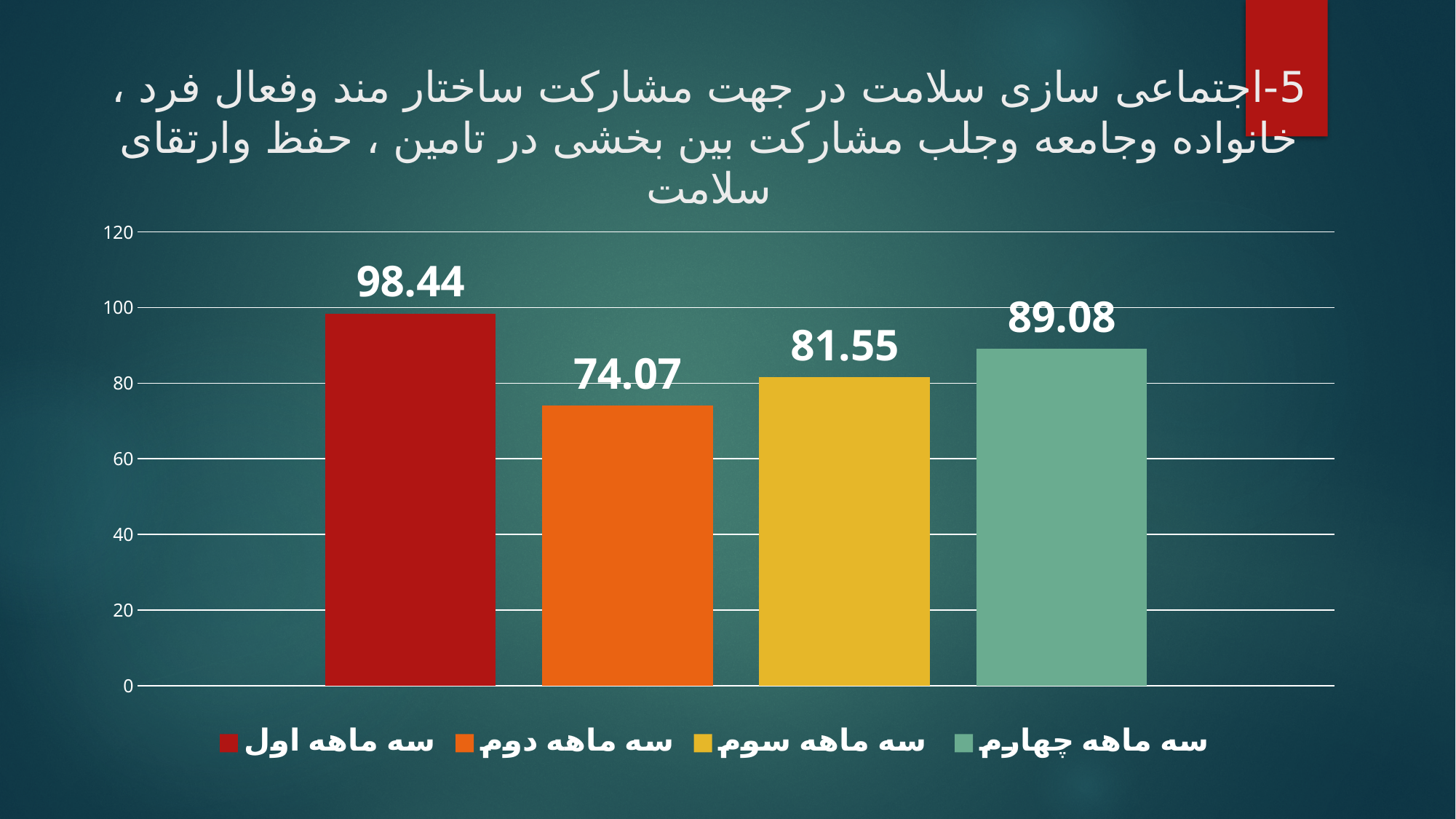
What is the value for سه ماهه سوم? 81.55 What kind of chart is shown on the slide? bar chart What is the value for سه ماهه اول? 98.44 Which quarter has the highest value? سه ماهه اول Is the value for سه ماهه اول greater or less than 100? less Which quarter has the lowest value? سه ماهه دوم How many entries does the legend list? 4 What is the value for سه ماهه دوم? 74.07 What is the difference between the values for سه ماهه اول and سه ماهه دوم? 24.37 Which is larger, the value for سه ماهه سوم or سه ماهه چهارم? سه ماهه چهارم What is the value for سه ماهه چهارم? 89.08 How many bars are plotted in the chart? 4